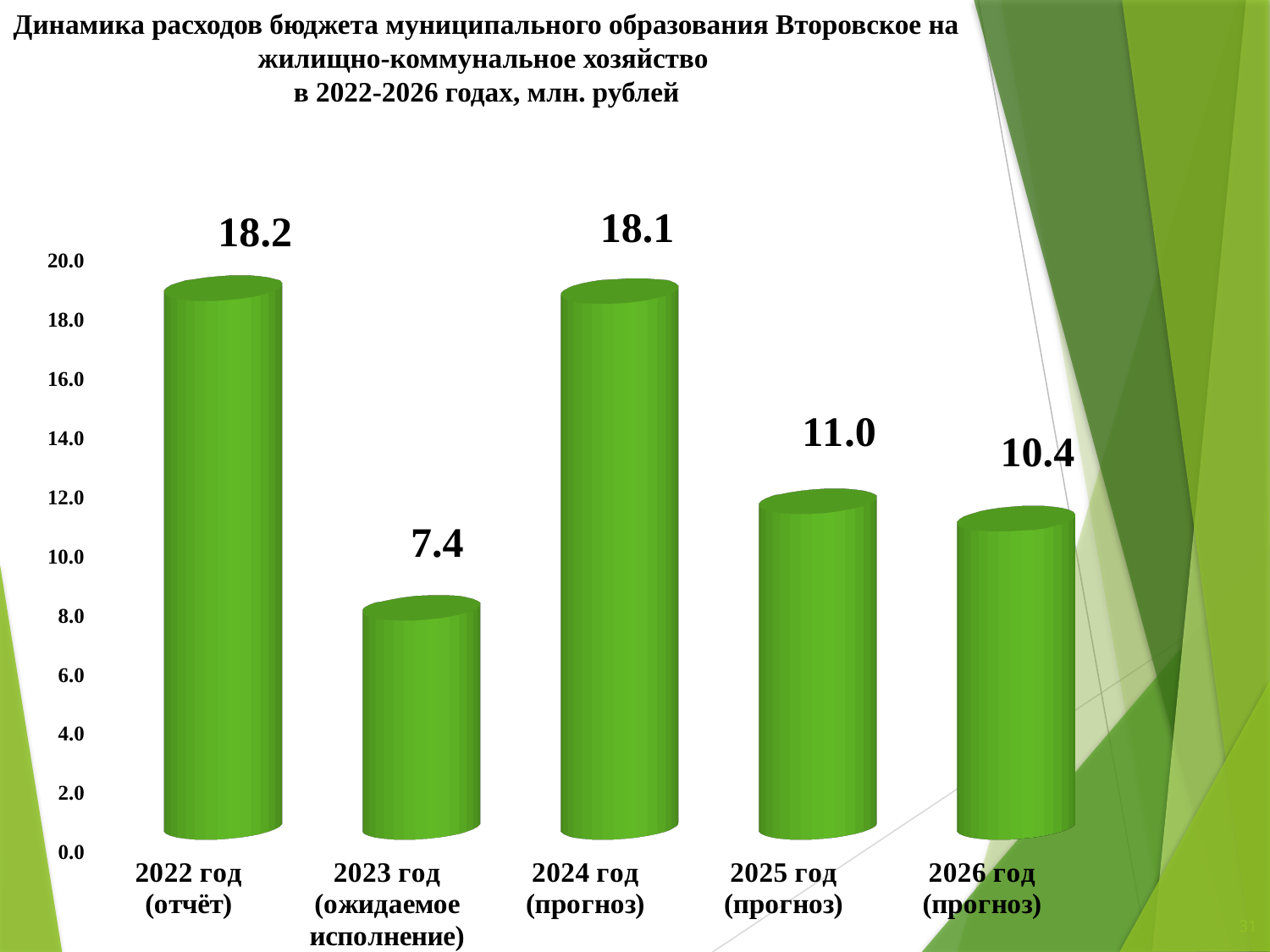
What is the difference between the values for 2024 год (прогноз) and 2023 год (ожидаемое исполнение)? 10.7 What is the value for 2022 год (отчёт)? 18.2 Which year has the highest value? 2022 год (отчёт) What kind of chart is shown on the slide? bar chart What is the value for 2023 год (ожидаемое исполнение)? 7.4 What is the value for 2026 год (прогноз)? 10.4 Which year has the lowest value? 2023 год (ожидаемое исполнение) Is the value for 2024 год (прогноз) greater or less than 16.0? greater What is the value for 2025 год (прогноз)? 11.0 Which is larger, the value for 2025 год (прогноз) or 2026 год (прогноз)? 2025 год (прогноз) What unit of measurement is stated in the chart title? млн. рублей How many years are shown on the chart? 5